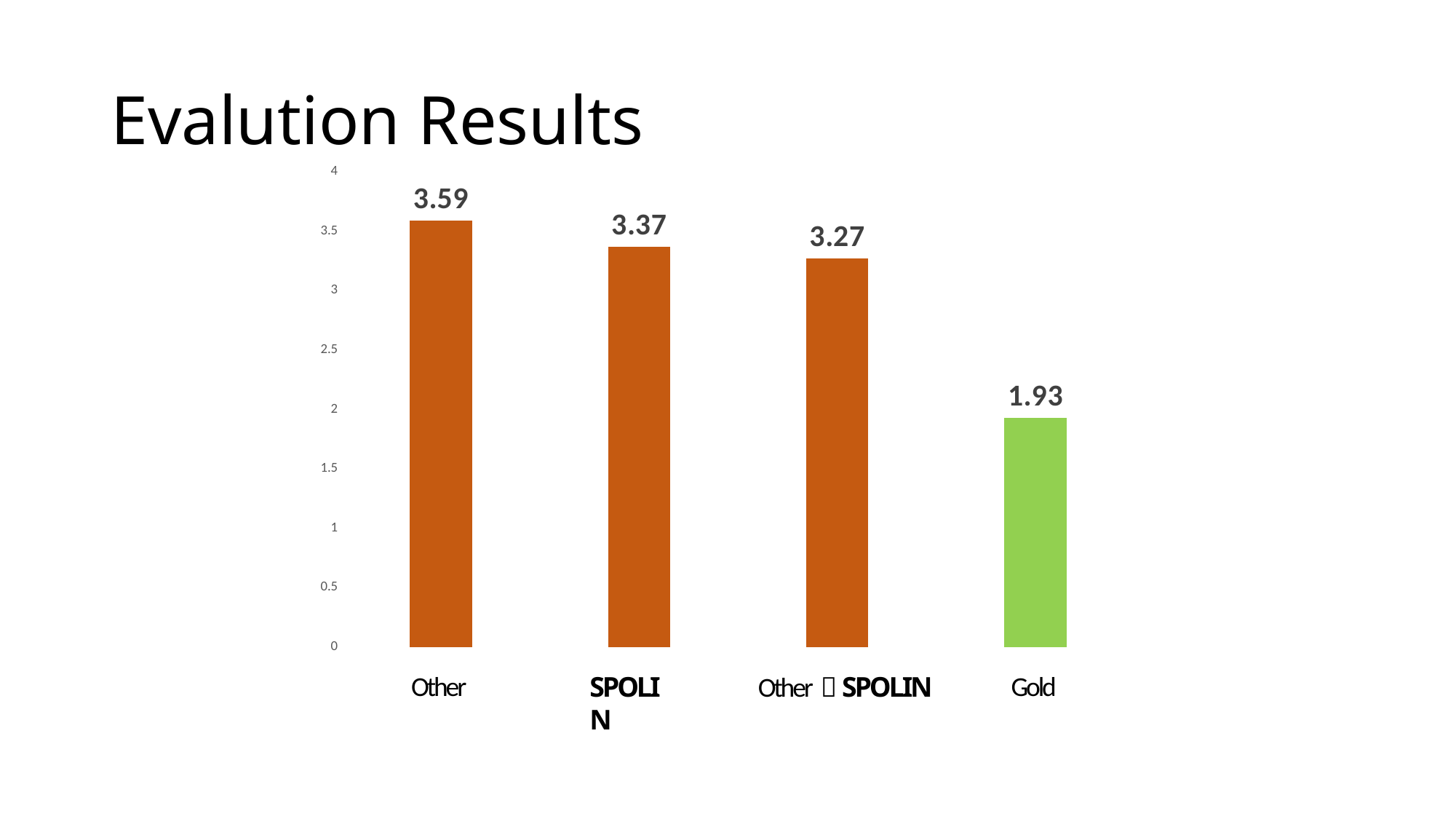
Which is larger, the value for SPOLIN or the value for Gold? SPOLIN What is the value for Other? 3.59 What colour is the Gold bar? green What is the value for Gold? 1.93 How many bars are shown in the chart? 4 Which category has the lowest value? Gold Is the value for Gold greater or less than 2? less What is the difference between the values for SPOLIN and Gold? 1.44 Which category has the highest value? Other What kind of chart is shown on the slide? bar chart What is the value for SPOLIN? 3.37 What is the difference between the values for Other and SPOLIN? 0.22